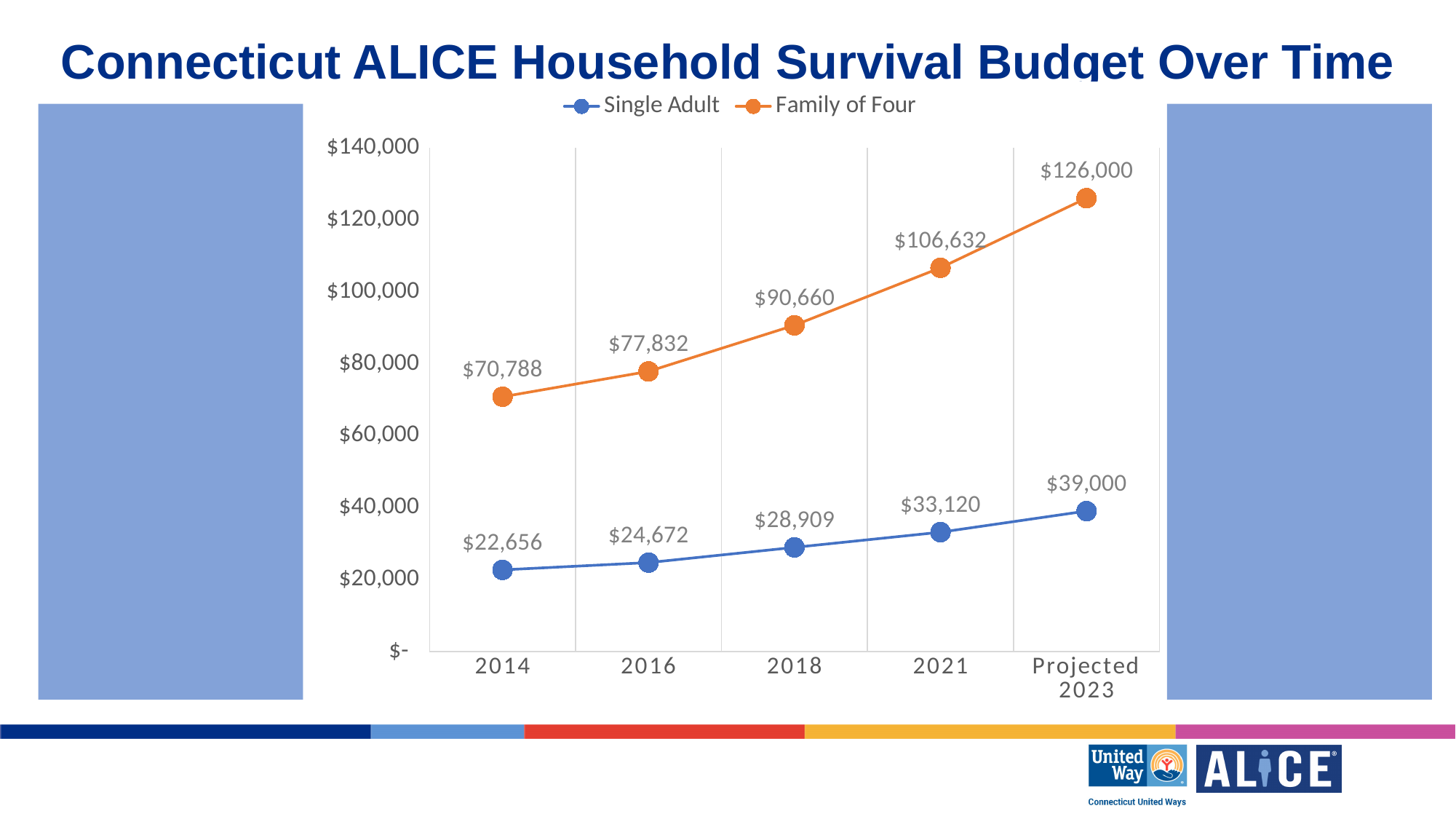
In which year is the Single Adult survival budget lowest? 2014 In which year is the Family of Four survival budget highest? Projected 2023 How many time points are plotted on the x axis? 5 Which is larger: the Family of Four budget in 2016 or the Family of Four budget in 2018? 2018 Does the Family of Four survival budget rise or fall from 2014 to Projected 2023? Rise What is the Single Adult survival budget in 2021? $33,120 What is the projected 2023 Family of Four survival budget? $126,000 What is the difference between the Family of Four and Single Adult budgets in 2014? $48,132 What is the Family of Four survival budget in 2018? $90,660 How many series does the legend list? 2 By how much does the Single Adult budget increase from 2021 to Projected 2023? $5,880 What kind of chart is shown on the slide? Line chart